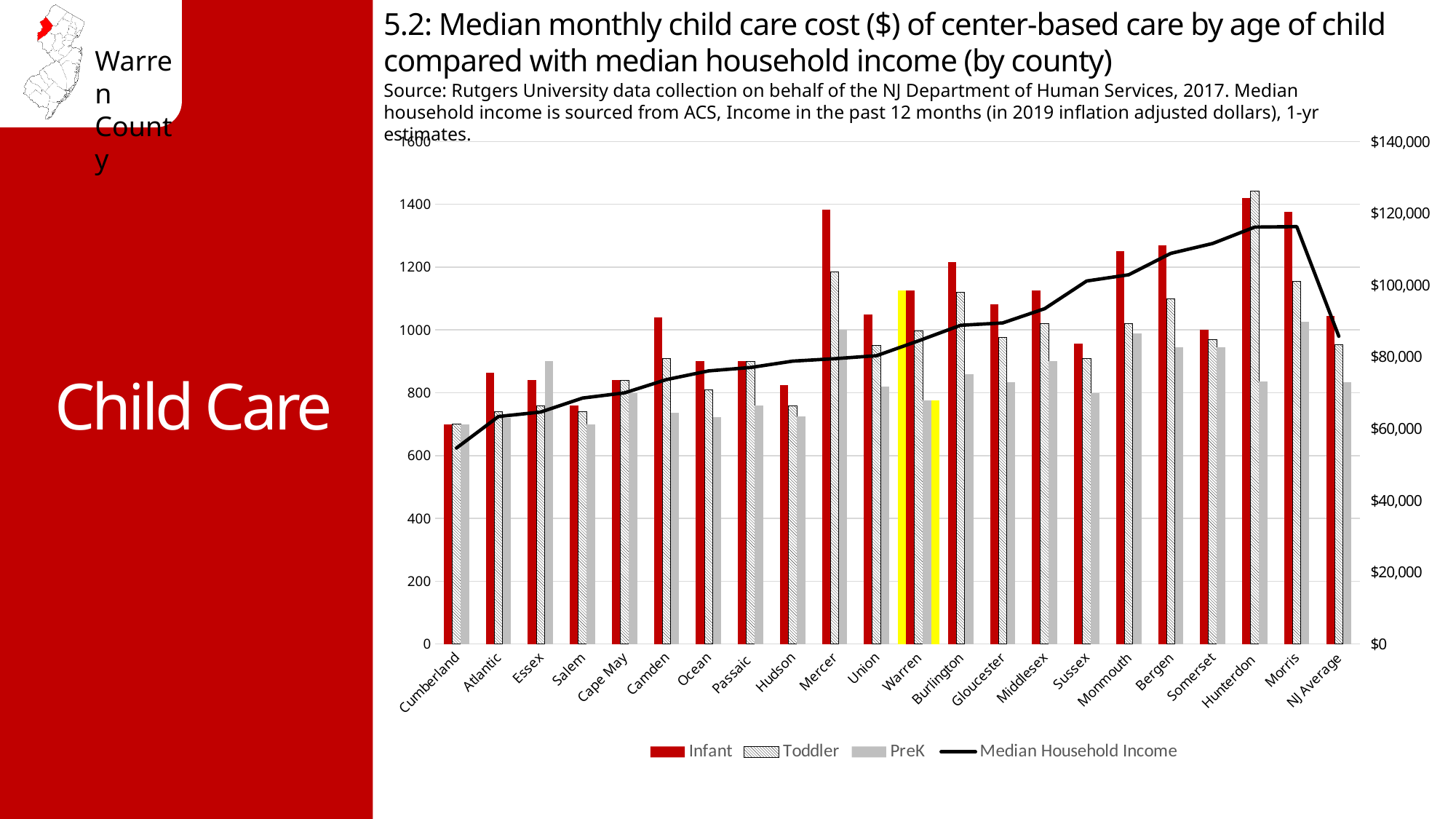
Is the Infant value for Mercer greater or less than 1200? greater Which county's bars are highlighted in yellow on the chart? Warren How many counties/categories are shown along the x axis of the chart? 22 What kind of chart is used to show the child care costs? bar chart (with a line for median household income) Which category has the highest Infant bar? Hunterdon Does the Median Household Income line generally rise or fall from Cumberland to Morris? rise Is the Infant value for Cumberland greater or less than 800? less Which category has the highest Toddler bar? Hunterdon Which category has the lowest Infant bar? Cumberland Which is larger, the Infant value for Mercer or the Infant value for Union? Mercer How many series does the chart legend list? 4 Is the Median Household Income for Morris greater or less than $100,000? greater